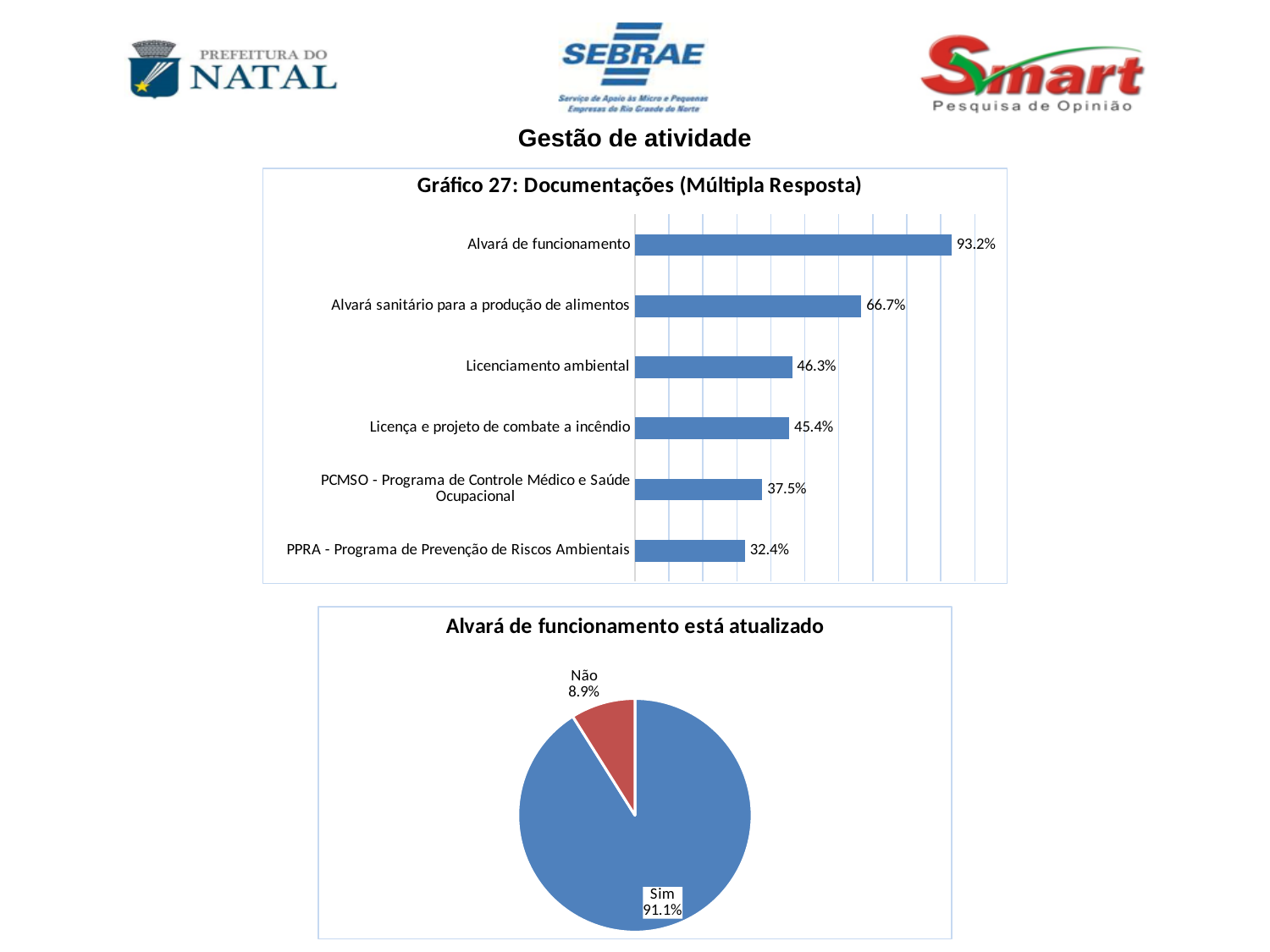
In the chart 'Alvará de funcionamento está atualizado', what share of the pie is Sim? 91.1% In the chart 'Gráfico 27: Documentações (Múltipla Resposta)', which is larger: PCMSO - Programa de Controle Médico e Saúde Ocupacional or Licença e projeto de combate a incêndio? Licença e projeto de combate a incêndio What kind of chart is 'Alvará de funcionamento está atualizado'? Pie chart In the chart 'Gráfico 27: Documentações (Múltipla Resposta)', what is the difference between Alvará de funcionamento and Alvará sanitário para a produção de alimentos? 26.5% In the chart 'Gráfico 27: Documentações (Múltipla Resposta)', which category has the highest value? Alvará de funcionamento In the chart 'Gráfico 27: Documentações (Múltipla Resposta)', what is the value for Licenciamento ambiental? 46.3% How many categories are shown in the chart 'Gráfico 27: Documentações (Múltipla Resposta)'? 6 In the chart 'Gráfico 27: Documentações (Múltipla Resposta)', which category has the lowest value? PPRA - Programa de Prevenção de Riscos Ambientais In the chart 'Gráfico 27: Documentações (Múltipla Resposta)', what is the value for Alvará de funcionamento? 93.2% In the chart 'Gráfico 27: Documentações (Múltipla Resposta)', what is the value for PPRA - Programa de Prevenção de Riscos Ambientais? 32.4% What kind of chart is 'Gráfico 27: Documentações (Múltipla Resposta)'? Bar chart In the chart 'Alvará de funcionamento está atualizado', what is the value for Não? 8.9%